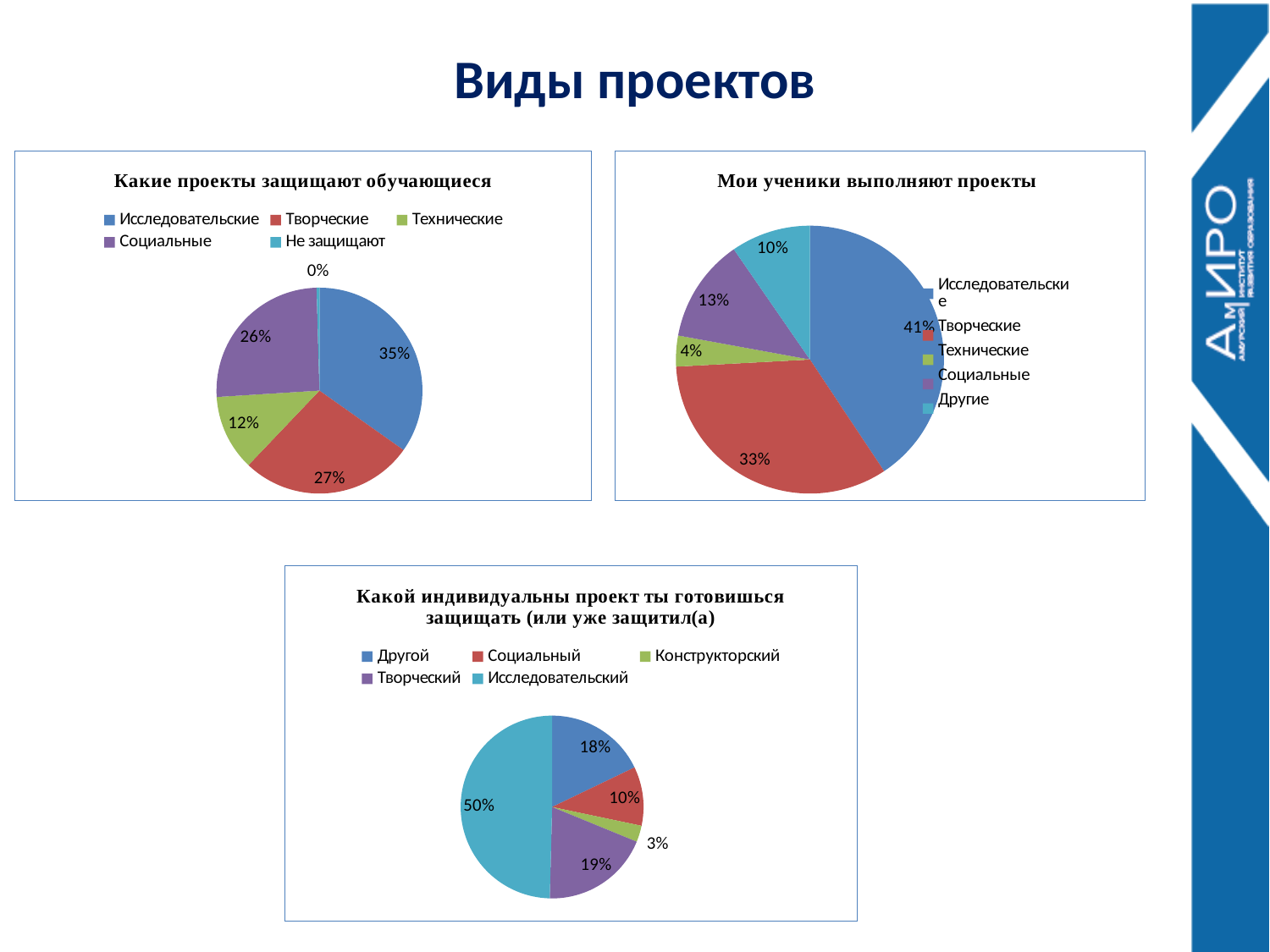
In the chart titled "Какие проекты защищают обучающиеся", how many entries does the legend list? 5 In the chart titled "Какие проекты защищают обучающиеся", what is the difference between the shares for Творческие and Технические? 15% In the chart titled "Мои ученики выполняют проекты", what share is labelled for Творческие? 33% In the chart at the bottom of the slide, which category has the smallest share? Конструкторский In the chart titled "Какие проекты защищают обучающиеся", what share is labelled for Исследовательские? 35% In the chart titled "Мои ученики выполняют проекты", what share is labelled for Технические? 4% In the chart at the bottom of the slide, what share is labelled for Исследовательский? 50% In the chart titled "Какие проекты защищают обучающиеся", which category has the smallest share? Не защищают What type of chart is used in the chart at the bottom of the slide? Pie chart In the chart titled "Мои ученики выполняют проекты", which category has the largest share? Исследовательские In the chart titled "Мои ученики выполняют проекты", which is larger: Социальные or Другие? Социальные In the chart at the bottom of the slide, what is the difference between the shares for Творческий and Социальный? 9%